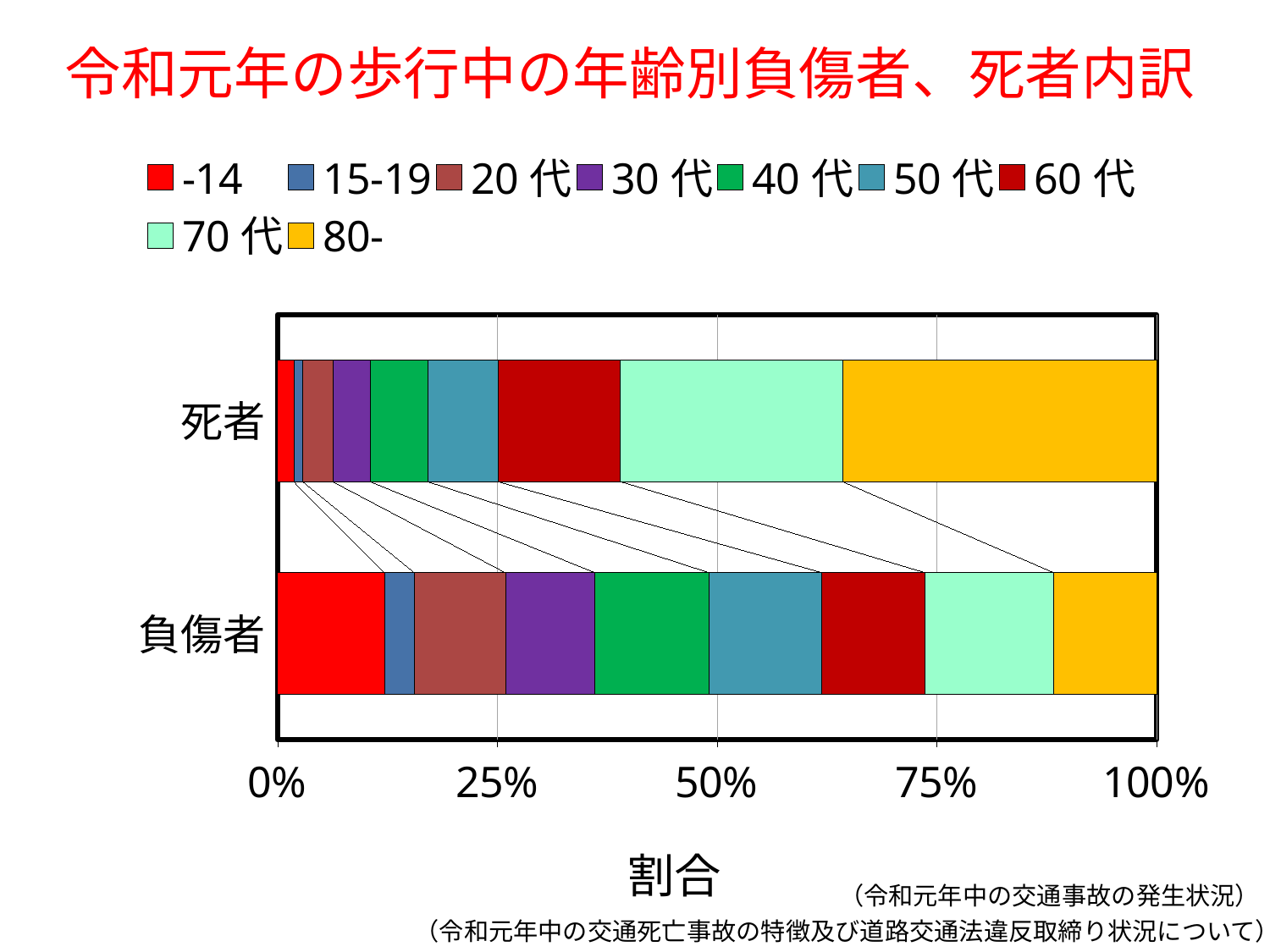
Which bar has the larger share for the -14 age group, 死者 or 負傷者? 負傷者 Which age group has the largest share of the 死者 bar? 80- How many categories (bars) does the chart show? 2 Which bar has the larger share for the 80- age group, 死者 or 負傷者? 死者 Which age group has the smallest share of the 負傷者 bar? 15-19 Is the share of -14 in the 負傷者 bar greater or less than 25%? less What kind of chart is shown on the slide? Stacked bar chart What is the title of the chart on the slide? 令和元年の歩行中の年齢別負傷者、死者内訳 Is the share of 80- in the 死者 bar greater or less than 25%? greater How many series does the legend list? 9 What is the label of the horizontal axis? 割合 Which age group has the smallest share of the 死者 bar? 15-19